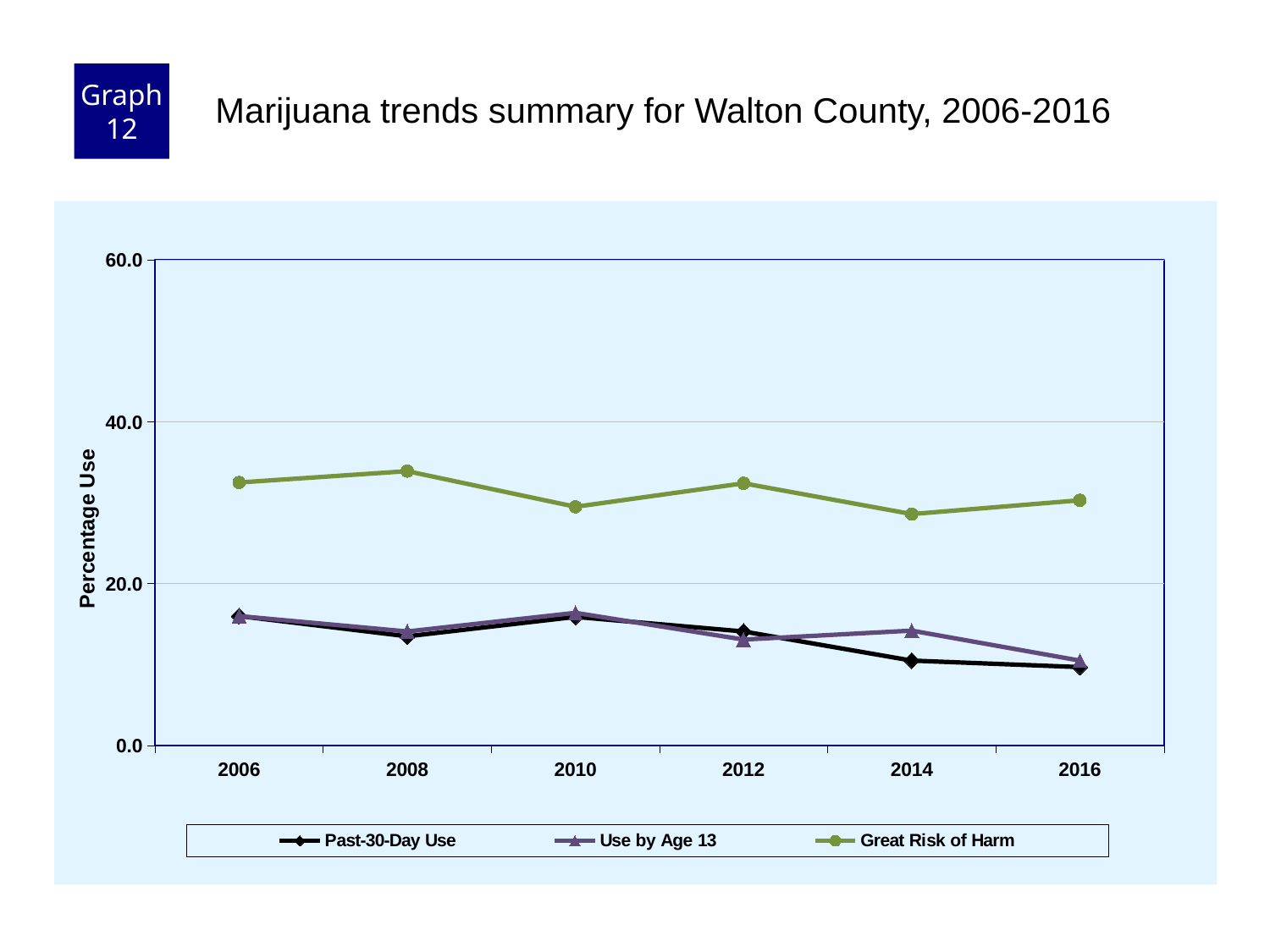
What is the label on the y axis? Percentage Use In which year is Great Risk of Harm at its highest? 2008 In 2014, which is larger: Use by Age 13 or Past-30-Day Use? Use by Age 13 Is the value for Great Risk of Harm in 2008 greater or less than 20.0? greater In which year is Use by Age 13 at its lowest? 2016 Is the value for Great Risk of Harm in 2012 greater or less than 40.0? less Which series has the highest values across all years? Great Risk of Harm How many years are plotted along the x axis? 6 What type of chart is shown on the slide? line chart How many series does the legend list? 3 Does Past-30-Day Use rise or fall from 2010 to 2016? fall Is the value for Past-30-Day Use in 2016 greater or less than 20.0? less